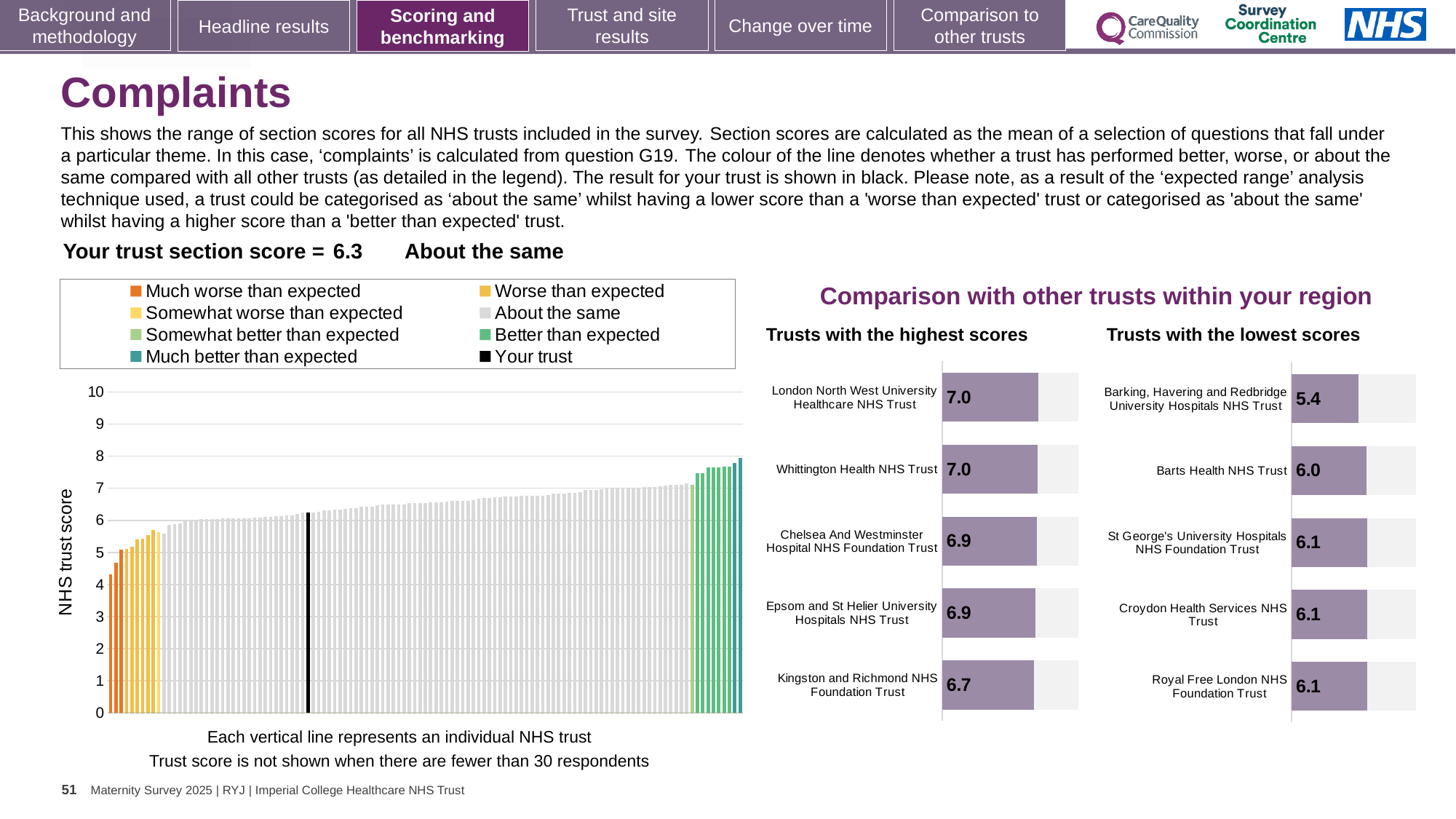
In the 'Trusts with the lowest scores' chart, which is larger: the score for Barts Health NHS Trust or the score for Barking, Havering and Redbridge University Hospitals NHS Trust? Barts Health NHS Trust In the 'Trusts with the lowest scores' chart, what is the score for Barking, Havering and Redbridge University Hospitals NHS Trust? 5.4 What kind of chart is the large chart on the left showing NHS trust scores? Bar chart In the 'Trusts with the highest scores' chart, what is the score for Kingston and Richmond NHS Foundation Trust? 6.7 In the 'Trusts with the lowest scores' chart, what is the difference between the score for Barts Health NHS Trust and the score for Barking, Havering and Redbridge University Hospitals NHS Trust? 0.6 In the large chart on the left, is the value of the lowest bar greater or less than 5? less In the large chart on the left, is the value of the black bar (your trust) greater or less than 7? less In the 'Trusts with the highest scores' chart, what is the score for Chelsea And Westminster Hospital NHS Foundation Trust? 6.9 In the 'Trusts with the lowest scores' chart, which trust has the lowest score? Barking, Havering and Redbridge University Hospitals NHS Trust How many entries does the legend above the large chart on the left list? 8 How many trusts are listed in the 'Trusts with the highest scores' chart? 5 In the 'Trusts with the highest scores' chart, what is the difference between the score for London North West University Healthcare NHS Trust and the score for Kingston and Richmond NHS Foundation Trust? 0.3